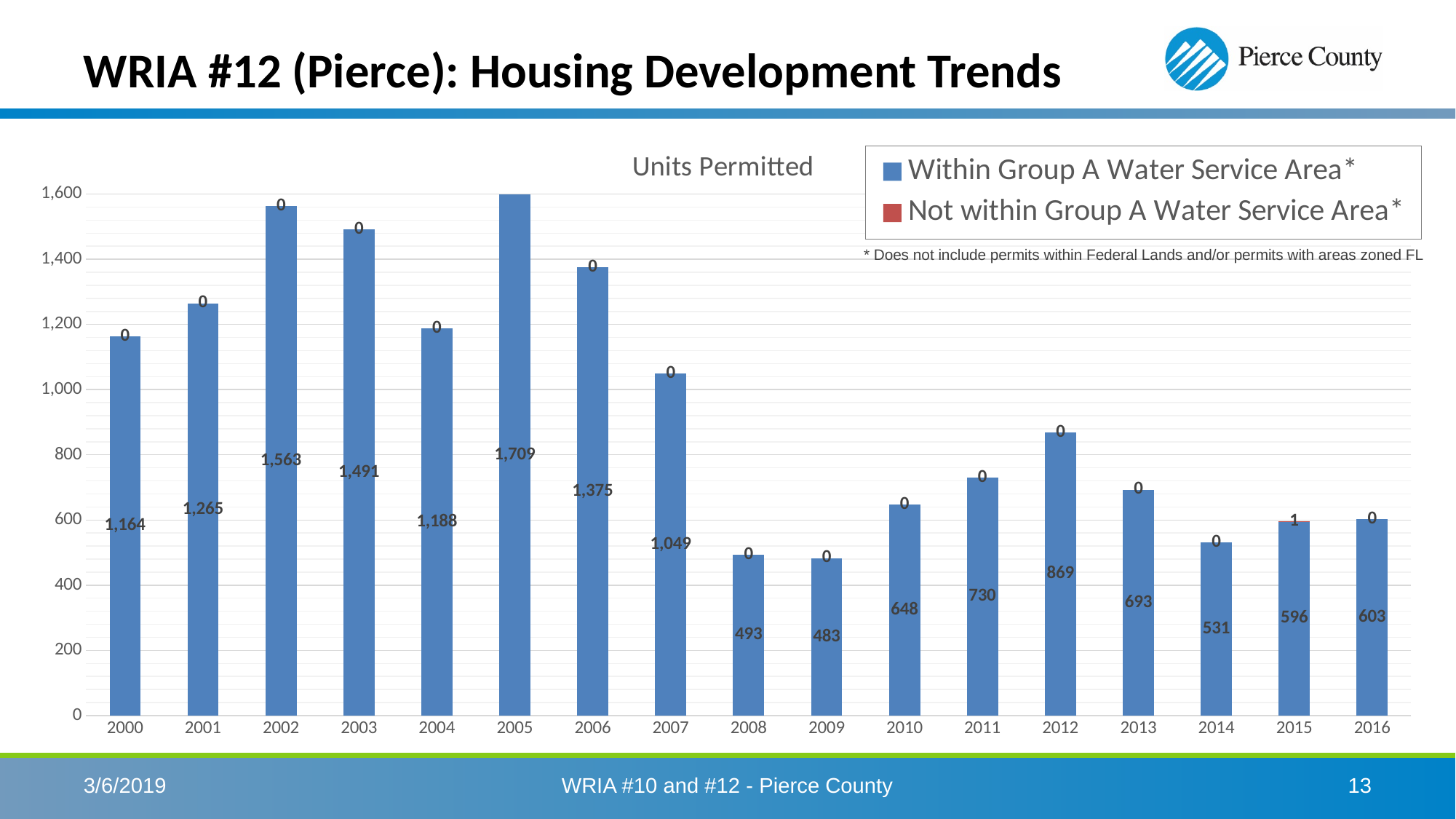
Which year has a larger Within Group A Water Service Area value, 2003 or 2006? 2003 What is the total of the stacked bar for 2015? 597 What is the value for Within Group A Water Service Area in 2009? 483 What is the value for Within Group A Water Service Area in 2002? 1,563 Do the Within Group A Water Service Area values rise or fall from 2005 to 2009? Fall How many years are shown on the x axis? 17 Which year has the lowest value for Within Group A Water Service Area? 2009 What is the value for Not within Group A Water Service Area in 2015? 1 What kind of chart is shown on the slide? Bar chart How many series does the legend list? 2 Which year has the highest value for Within Group A Water Service Area? 2005 What is the difference between the Within Group A Water Service Area values for 2012 and 2013? 176